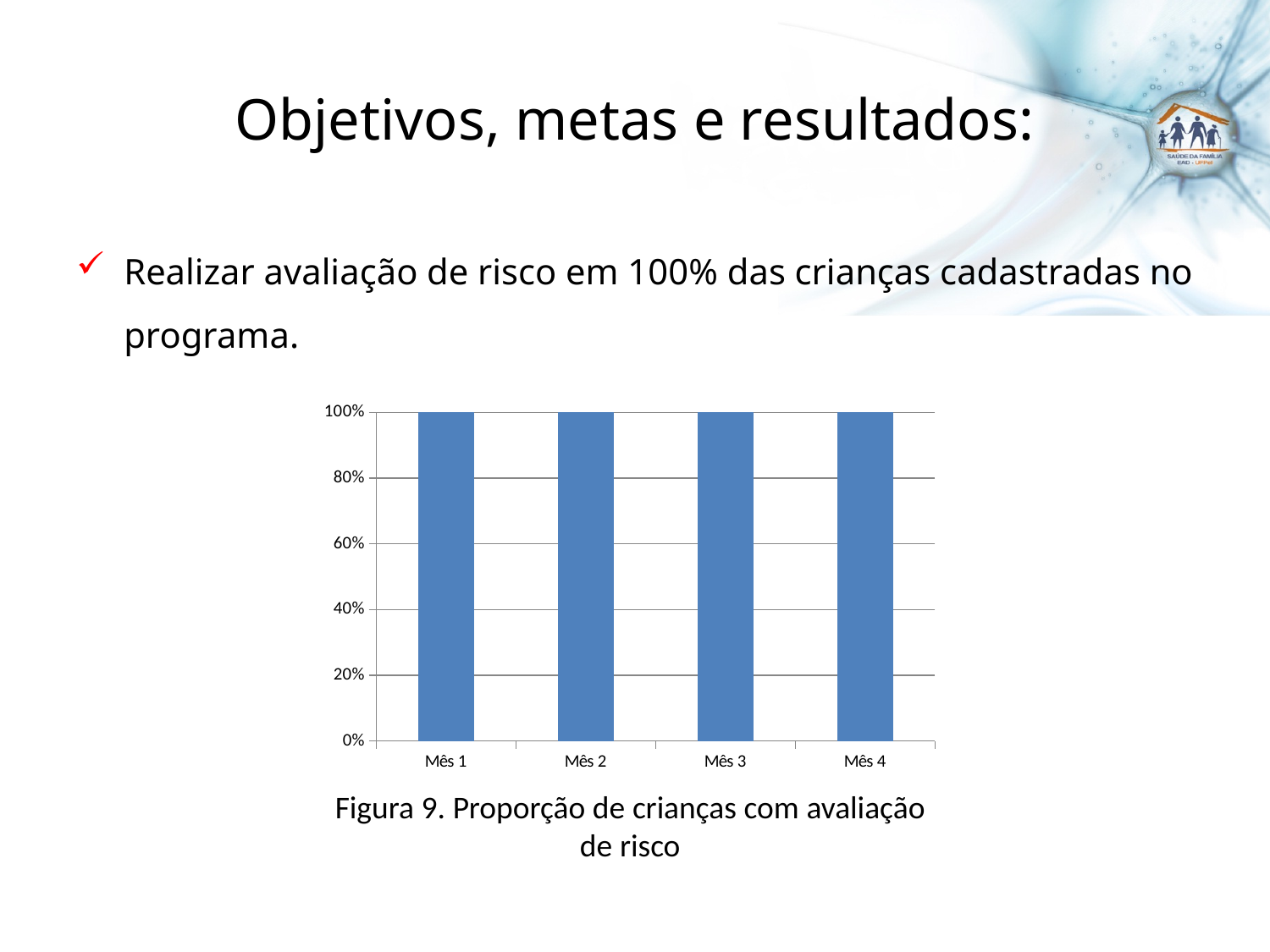
What is the value for Mês 1? 100% What is the difference between the values for Mês 1 and Mês 4? 0% Is the value for Mês 4 greater or less than 60%? greater What is the value for Mês 3? 100% Do the values rise, fall or stay the same from Mês 1 to Mês 4? stay the same What is the value for Mês 4? 100% Is the value for Mês 2 greater or less than 80%? greater What is the highest value shown on the y axis? 100% What is the value for Mês 2? 100% What is the caption of the figure shown below the chart? Figura 9. Proporção de crianças com avaliação de risco What kind of chart is shown on the slide? bar chart How many categories are shown on the x axis? 4